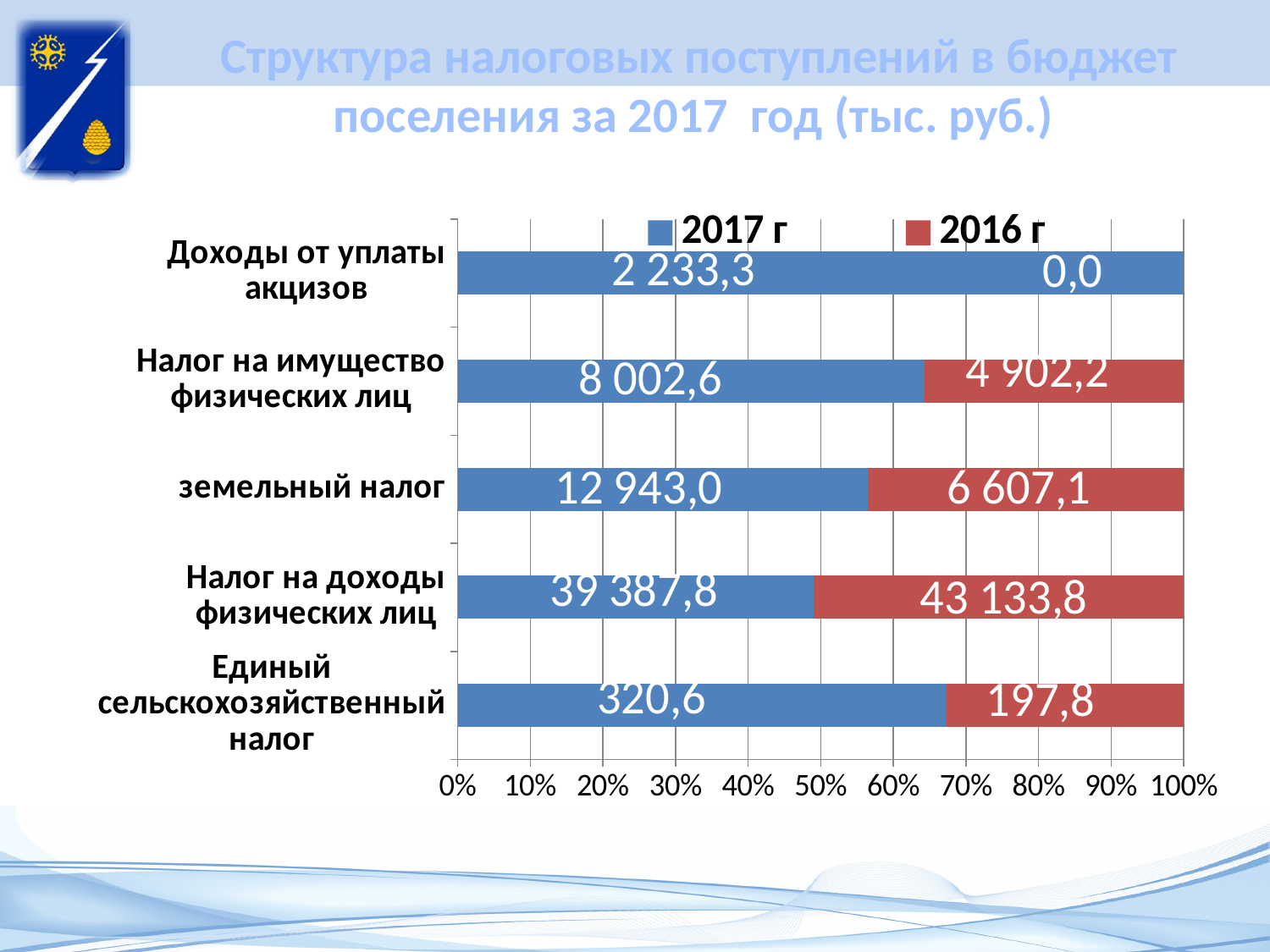
For земельный налог, which year has the larger value, 2017 г or 2016 г? 2017 г What is the difference between the 2017 г and 2016 г values for Налог на имущество физических лиц? 3 100,4 What is the 2017 г value for земельный налог? 12 943,0 What kind of chart is shown on the slide? Stacked bar chart What is the 2016 г value for Доходы от уплаты акцизов? 0,0 What is the difference between the 2016 г and 2017 г values for Налог на доходы физических лиц? 3 746,0 Which category has the highest 2017 г value? Налог на доходы физических лиц What is the 2016 г value for Налог на имущество физических лиц? 4 902,2 How many categories are shown on the chart? 5 What is the 2017 г value for Единый сельскохозяйственный налог? 320,6 Which category has the lowest 2017 г value? Единый сельскохозяйственный налог How many series does the legend list? 2